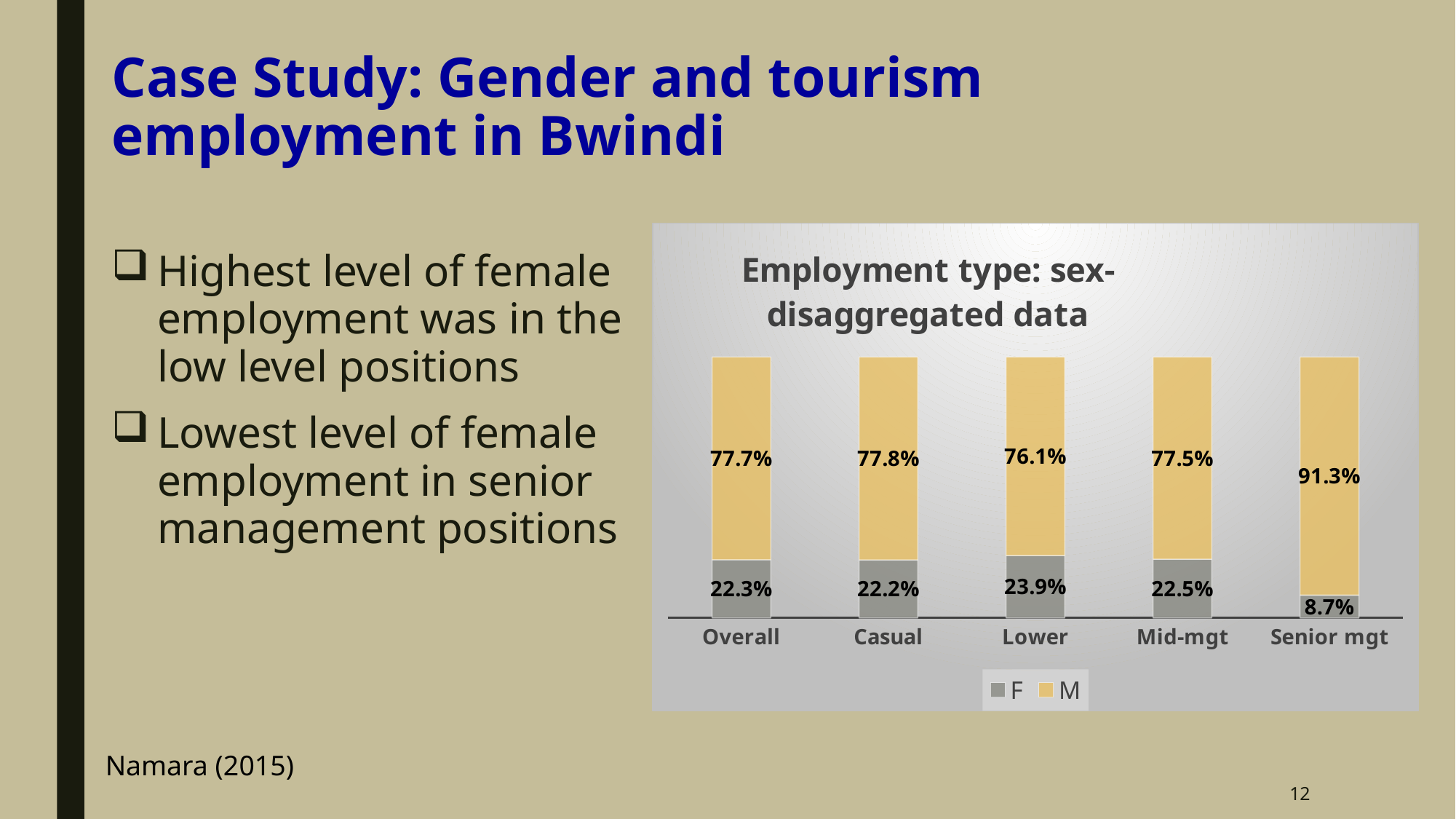
Which is larger: the F value for Lower or the F value for Casual? Lower What kind of chart is shown on the slide? Stacked bar chart How many categories are shown on the x axis? 5 What is the value for F in the Senior mgt category? 8.7% Which category has the lowest value for F? Senior mgt What is the value for M in the Lower category? 76.1% Which category has the highest value for M? Senior mgt What is the value for F in the Overall category? 22.3% How many series does the legend list? 2 Which category has the highest value for F? Lower What is the difference between the M value for Senior mgt and the M value for Overall? 13.6% What is the value for M in the Mid-mgt category? 77.5%